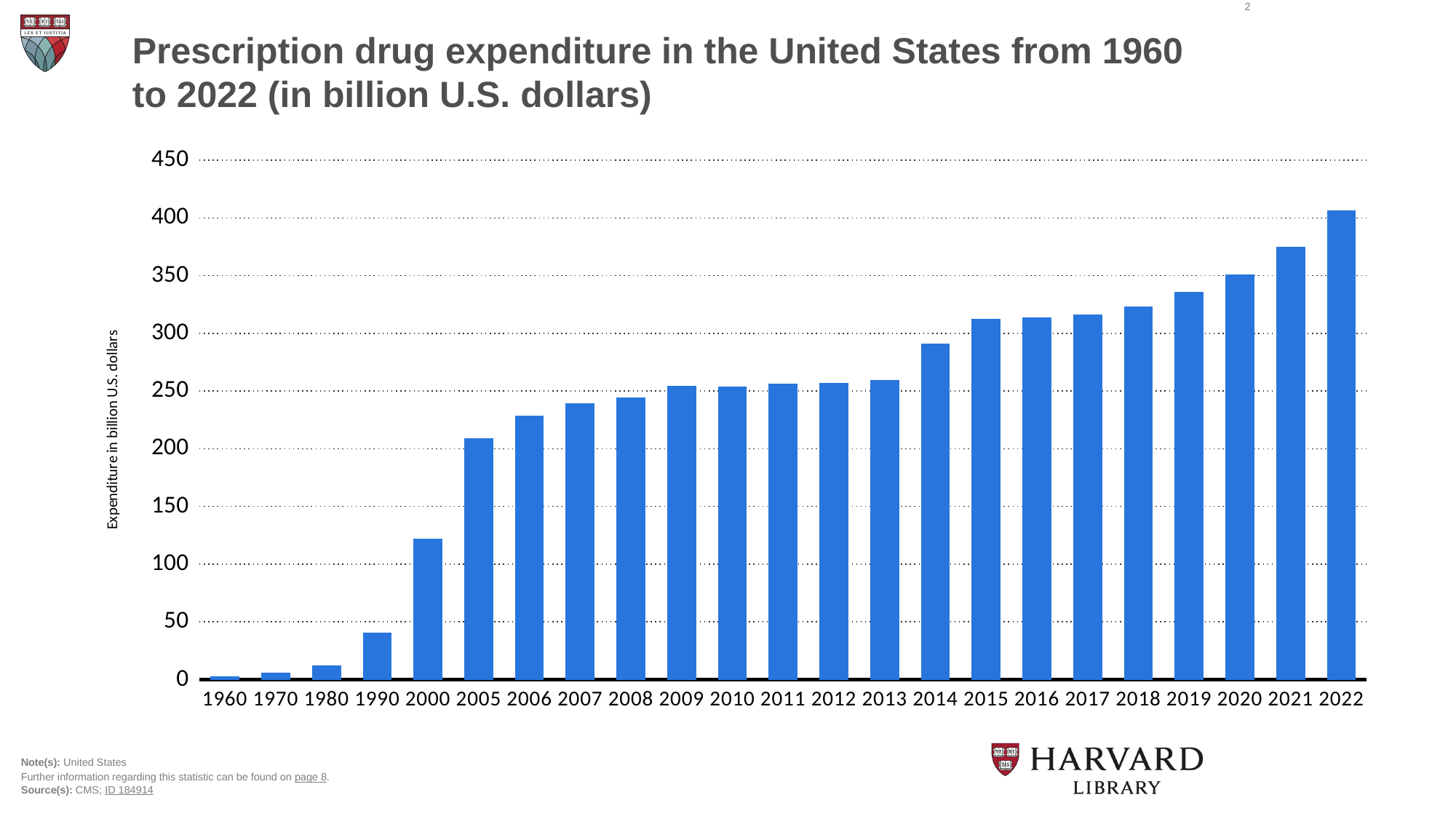
Is the value for 2014 greater or less than 300? less How many years are shown on the x axis of the chart? 23 Do the values generally rise or fall from 1960 to 2022? rise Is the value for 1990 greater or less than 50? less Is the value for 2000 greater or less than 100? greater Which year has the lowest prescription drug expenditure? 1960 What kind of chart is shown on the slide? bar chart What is the label of the vertical axis? Expenditure in billion U.S. dollars Which year has the larger expenditure, 2013 or 2014? 2014 Which year has the highest prescription drug expenditure? 2022